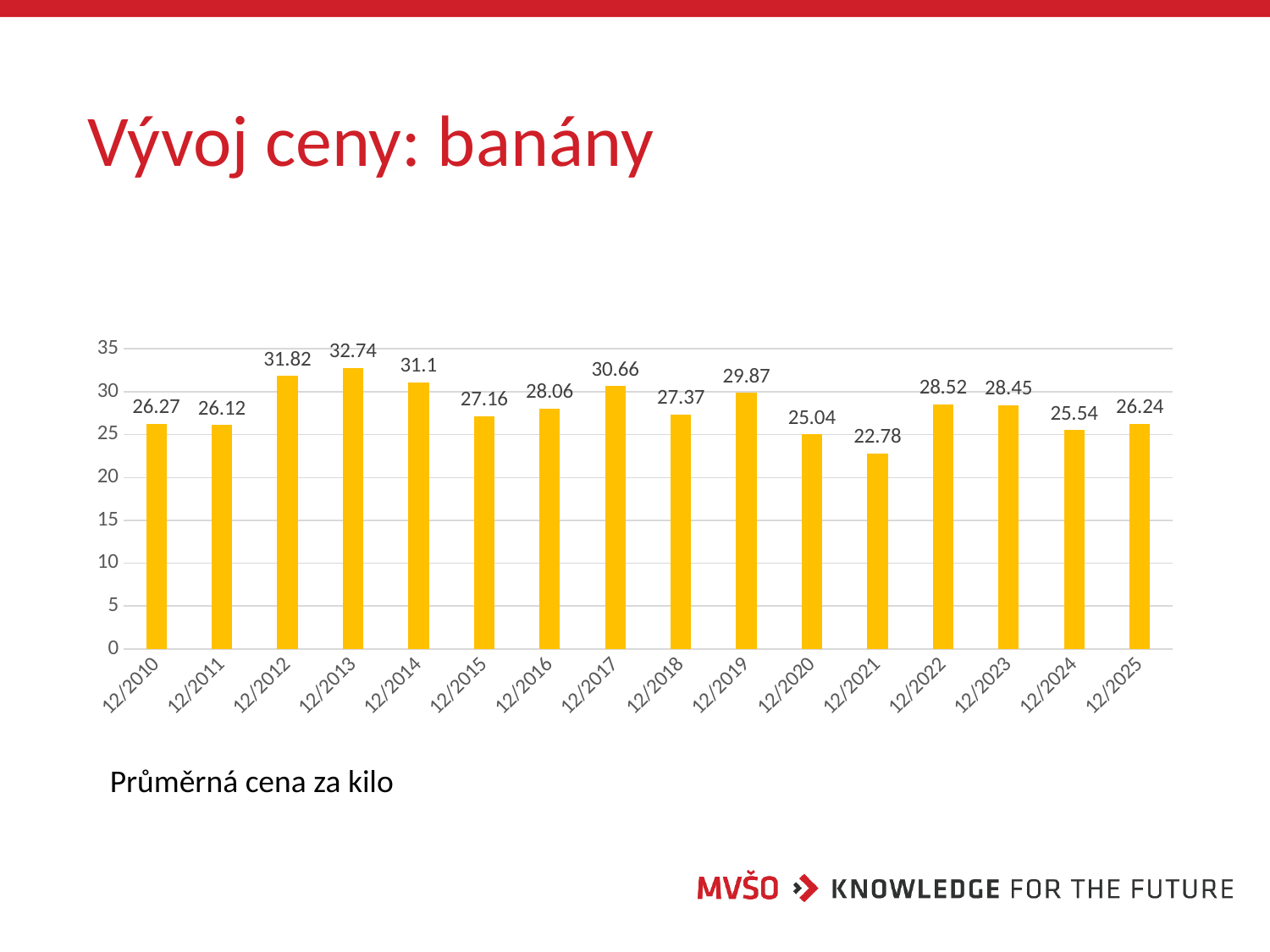
What is the value for 12/2013? 32.74 Which is larger, the value for 12/2017 or the value for 12/2019? 12/2017 What is the difference between the values for 12/2012 and 12/2011? 5.7 Is the value for 12/2021 greater or less than 25? less Which category has the lowest value? 12/2021 What kind of chart is shown on the slide? bar chart Which category has the highest value? 12/2013 What is the difference between the values for 12/2013 and 12/2021? 9.96 How many categories are shown on the x axis? 16 What is the value for 12/2025? 26.24 Do the values rise or fall from 12/2019 to 12/2021? fall What is the value for 12/2021? 22.78